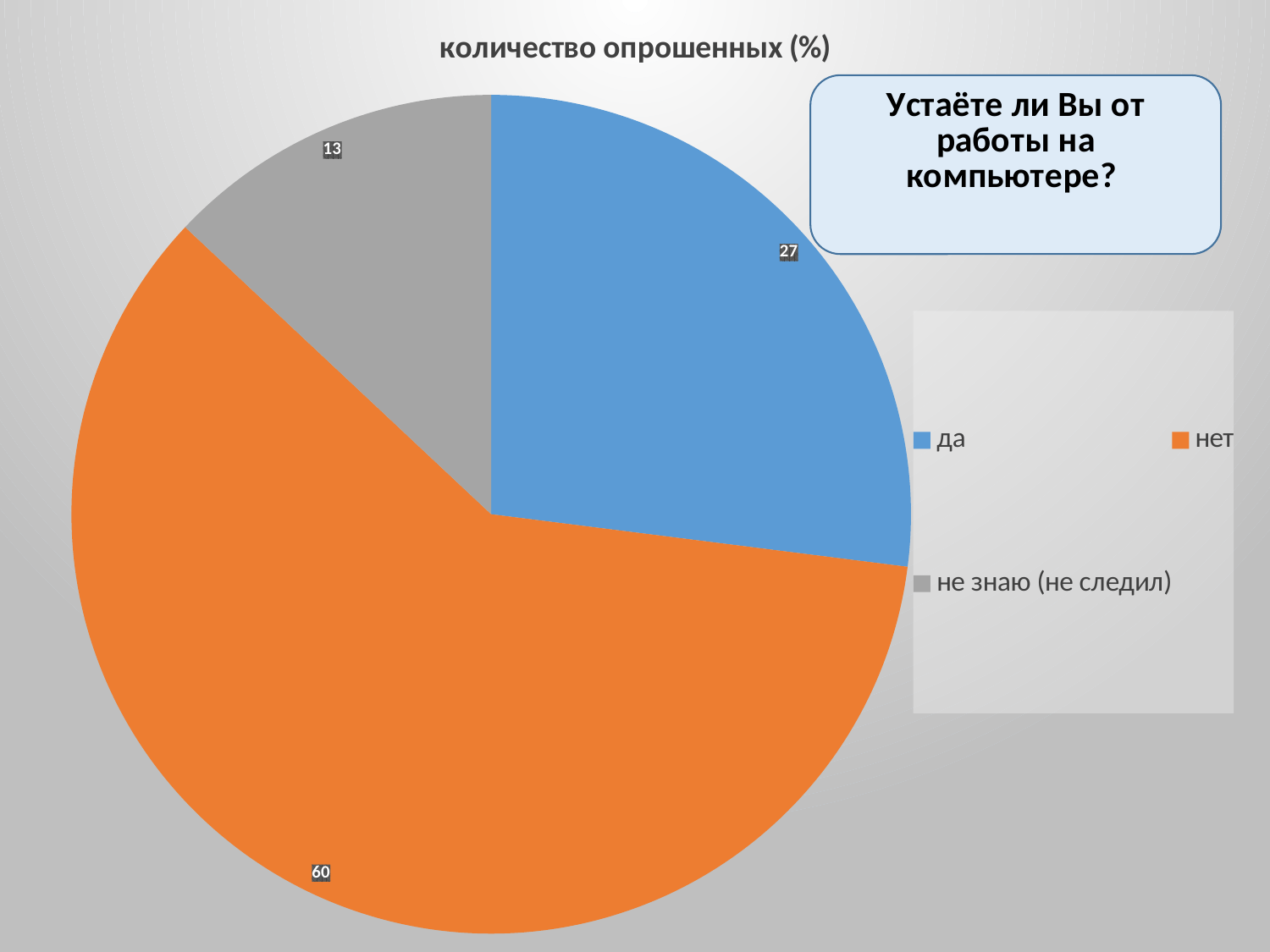
Which category has the smallest slice of the pie? не знаю (не следил) What is the value for "да" in the pie chart? 27 What is the value for "не знаю (не следил)" in the pie chart? 13 What is the difference between the values for "нет" and "да"? 33 Which is larger, the value for "да" or the value for "не знаю (не следил)"? да What type of chart is shown on the slide? pie chart What is the value for "нет" in the pie chart? 60 Which category has the largest slice of the pie? нет How many slices does the pie chart have? 3 What share of the pie does the "нет" slice represent? 60% What is the difference between the values for "да" and "не знаю (не следил)"? 14 What is the title of the chart? количество опрошенных (%)